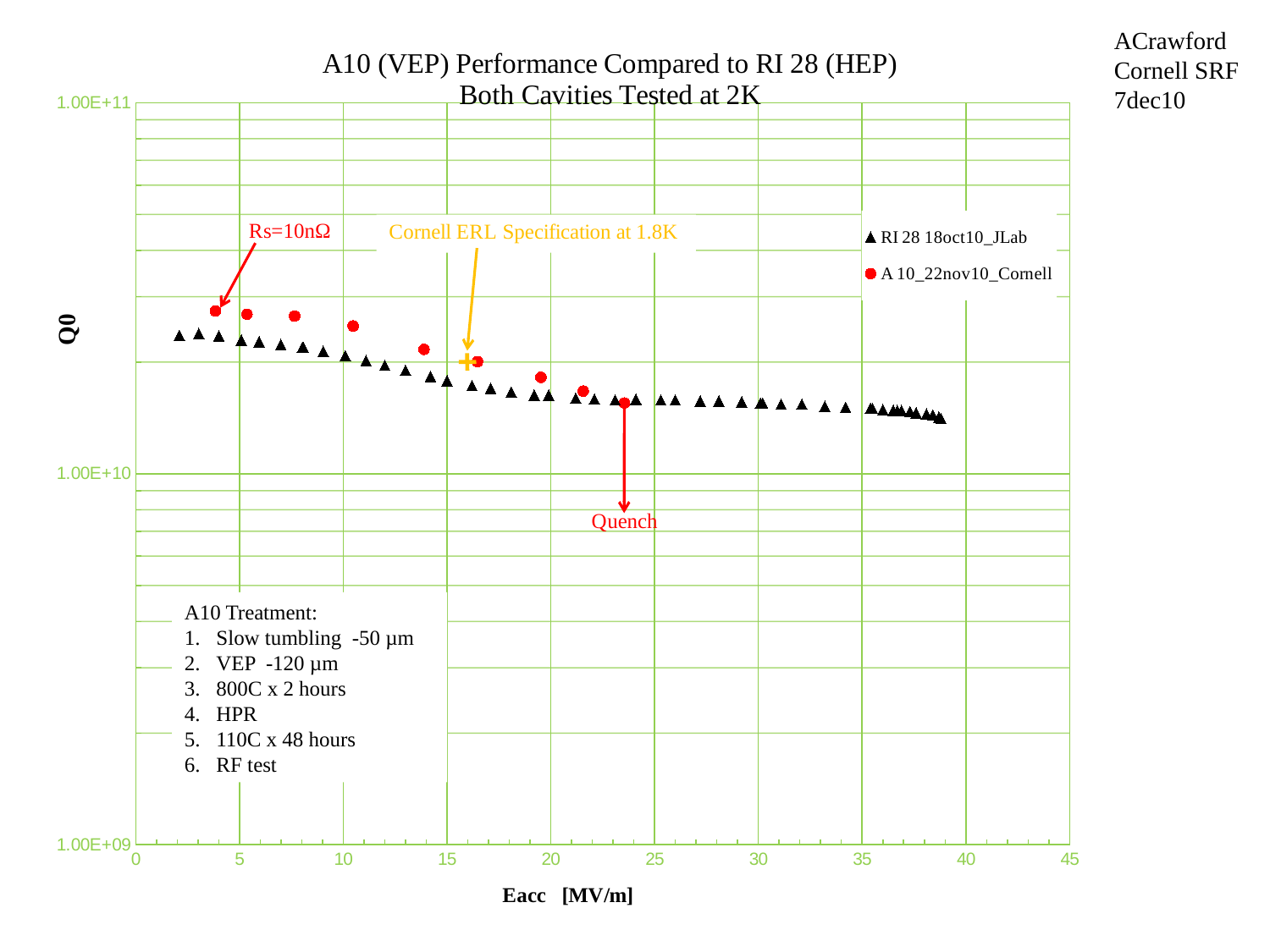
What is the title of the chart? A10 (VEP) Performance Compared to RI 28 (HEP) Both Cavities Tested at 2K Which series reaches the higher maximum Eacc value? RI 28 18oct10_JLab At Eacc around 5 MV/m, which series has the higher Q0: RI 28 18oct10_JLab or A 10_22nov10_Cornell? A 10_22nov10_Cornell Does Q0 rise or fall as Eacc increases for the A 10_22nov10_Cornell series? fall What is the label of the x axis? Eacc [MV/m] Is the Eacc value at which the A 10_22nov10_Cornell series quenches greater or less than 20 MV/m? greater How many data points are plotted for the A 10_22nov10_Cornell series? 9 Does Q0 rise or fall as Eacc increases for the RI 28 18oct10_JLab series? fall Is the Q0 value of the first A 10_22nov10_Cornell point (near Eacc 4 MV/m) greater or less than 1.00E+10? greater How many series does the chart legend list? 2 What kind of chart is shown on the slide? scatter chart Is the Q0 value of the last RI 28 18oct10_JLab point (near Eacc 39 MV/m) greater or less than 1.00E+11? less